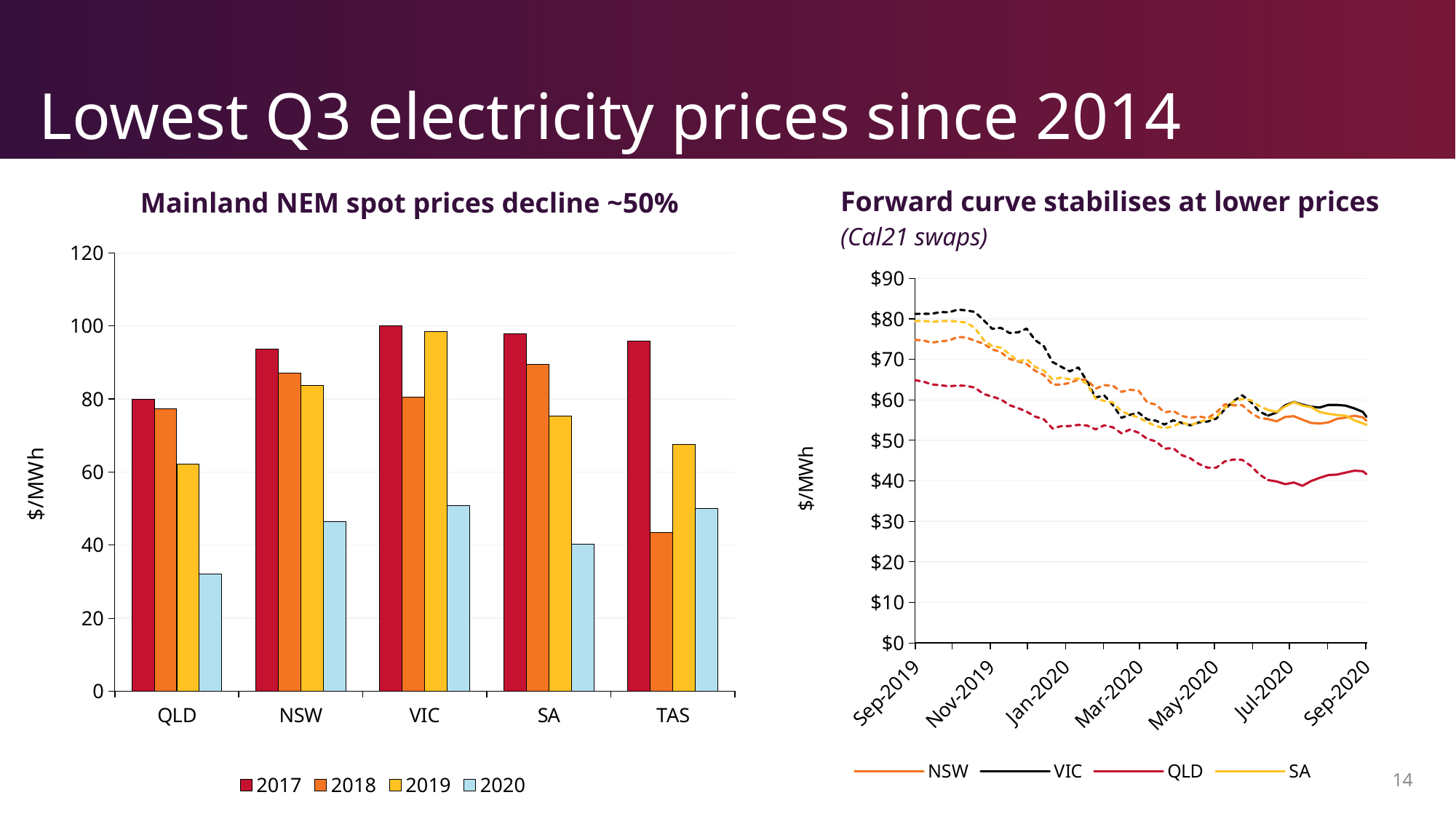
What kind of chart is the 'Mainland NEM spot prices decline ~50%' chart? bar chart In the 'Mainland NEM spot prices decline ~50%' chart, which region has the lowest 2020 value? QLD In the 'Mainland NEM spot prices decline ~50%' chart, which region has the highest 2019 value? VIC How many series does the legend of the 'Forward curve stabilises at lower prices' chart list? 4 How many regions are shown on the x axis of the 'Mainland NEM spot prices decline ~50%' chart? 5 In the 'Forward curve stabilises at lower prices' chart, do the lines generally rise or fall from Sep-2019 to Sep-2020? fall What kind of chart is the 'Forward curve stabilises at lower prices' chart? line chart How many series does the legend of the 'Mainland NEM spot prices decline ~50%' chart list? 4 In the 'Mainland NEM spot prices decline ~50%' chart, is the 2020 value for QLD greater or less than 40? less In the 'Mainland NEM spot prices decline ~50%' chart, which region has the lowest 2018 value? TAS In the 'Forward curve stabilises at lower prices' chart, which series is lowest at Sep-2020? QLD In the 'Mainland NEM spot prices decline ~50%' chart, is the 2017 value for NSW greater or less than 80? greater